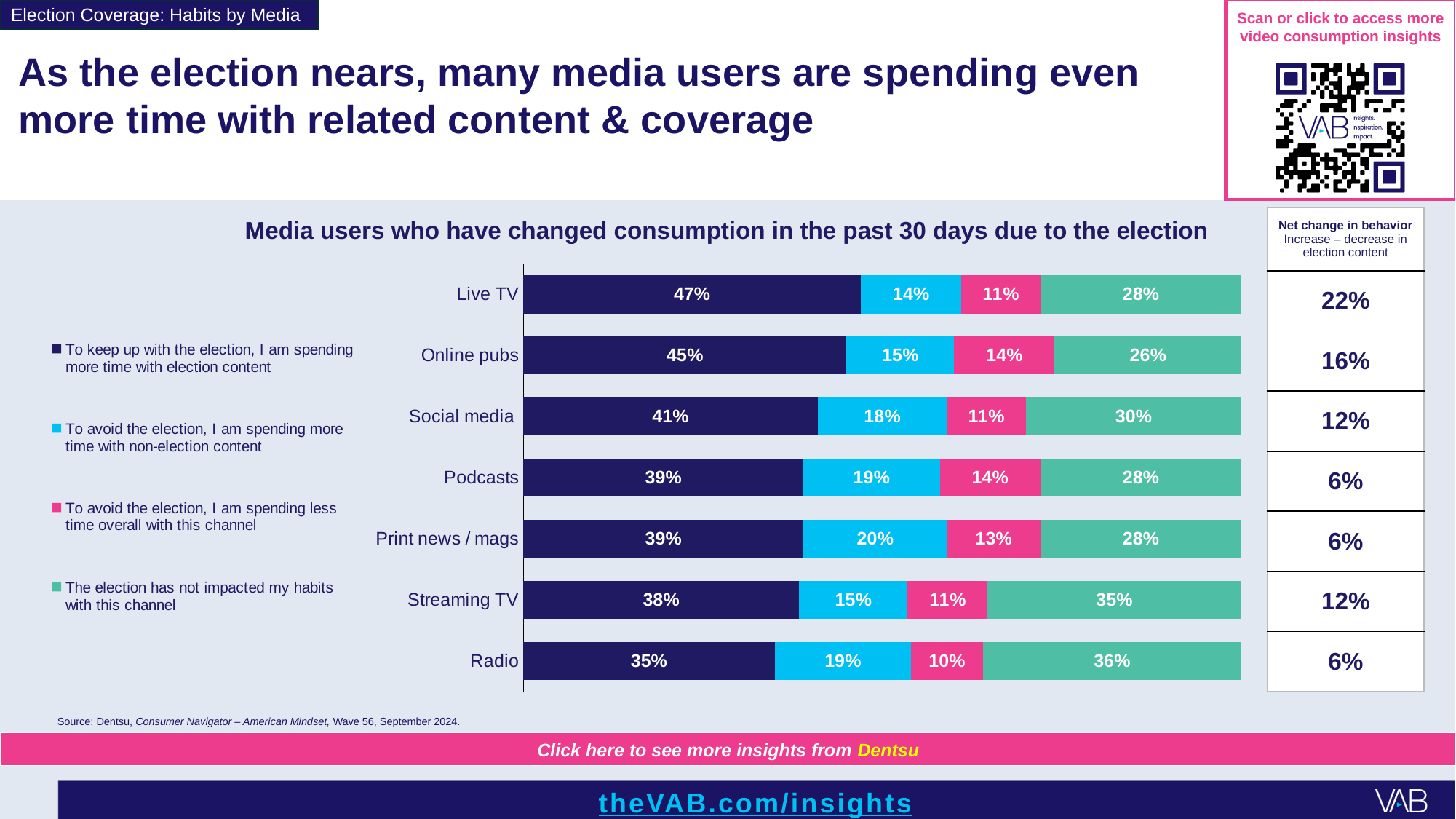
What is the title of the chart? Media users who have changed consumption in the past 30 days due to the election How many media channels are shown in the chart? 7 Which media channel has the lowest share of users spending more time with election content to keep up with the election? Radio What percentage of Radio users say the election has not impacted their habits with this channel? 36% Which media channel has the highest share of users spending more time with election content to keep up with the election? Live TV What percentage of Live TV users say they are spending more time with election content to keep up with the election? 47% What is the difference between the share of Live TV users and Radio users who are spending more time with election content? 12% What kind of chart is used to show media users who have changed consumption due to the election? Stacked bar chart How many series does the legend list? 4 What percentage of Print news / mags users say they are spending more time with non-election content to avoid the election? 20% Which has a larger share of users saying the election has not impacted their habits: Streaming TV or Social media? Streaming TV What is the net change in behavior shown for Online pubs? 16%